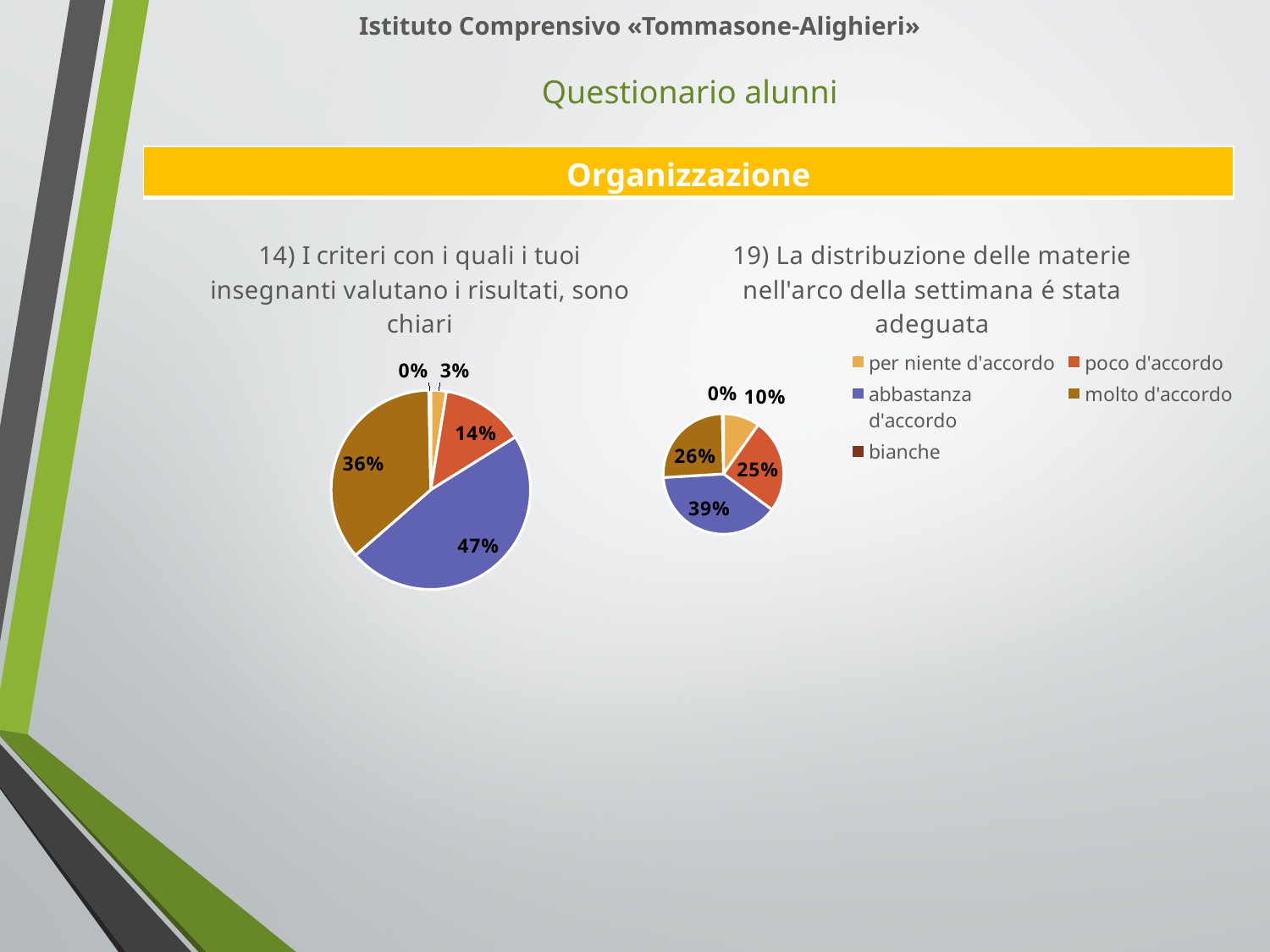
In the left chart (question 14), which response has the largest share? abbastanza d'accordo In the left chart (question 14), what share of respondents answered "molto d'accordo"? 36% In the right chart (question 19), what share of respondents answered "bianche"? 0% In the right chart (question 19), which response has the largest share? abbastanza d'accordo How many entries does the legend list? 5 In the right chart (question 19), what share of respondents answered "abbastanza d'accordo"? 39% In the right chart (question 19), what is the difference between the shares for "abbastanza d'accordo" and "molto d'accordo"? 13% In the right chart (question 19), what share of respondents answered "per niente d'accordo"? 10% In the left chart (question 14), what share of respondents answered "poco d'accordo"? 14% What kind of chart is used for question 19? pie chart In the left chart (question 14), what share of respondents answered "abbastanza d'accordo"? 47% In the left chart (question 14), which is larger: the share for "molto d'accordo" or the share for "poco d'accordo"? molto d'accordo